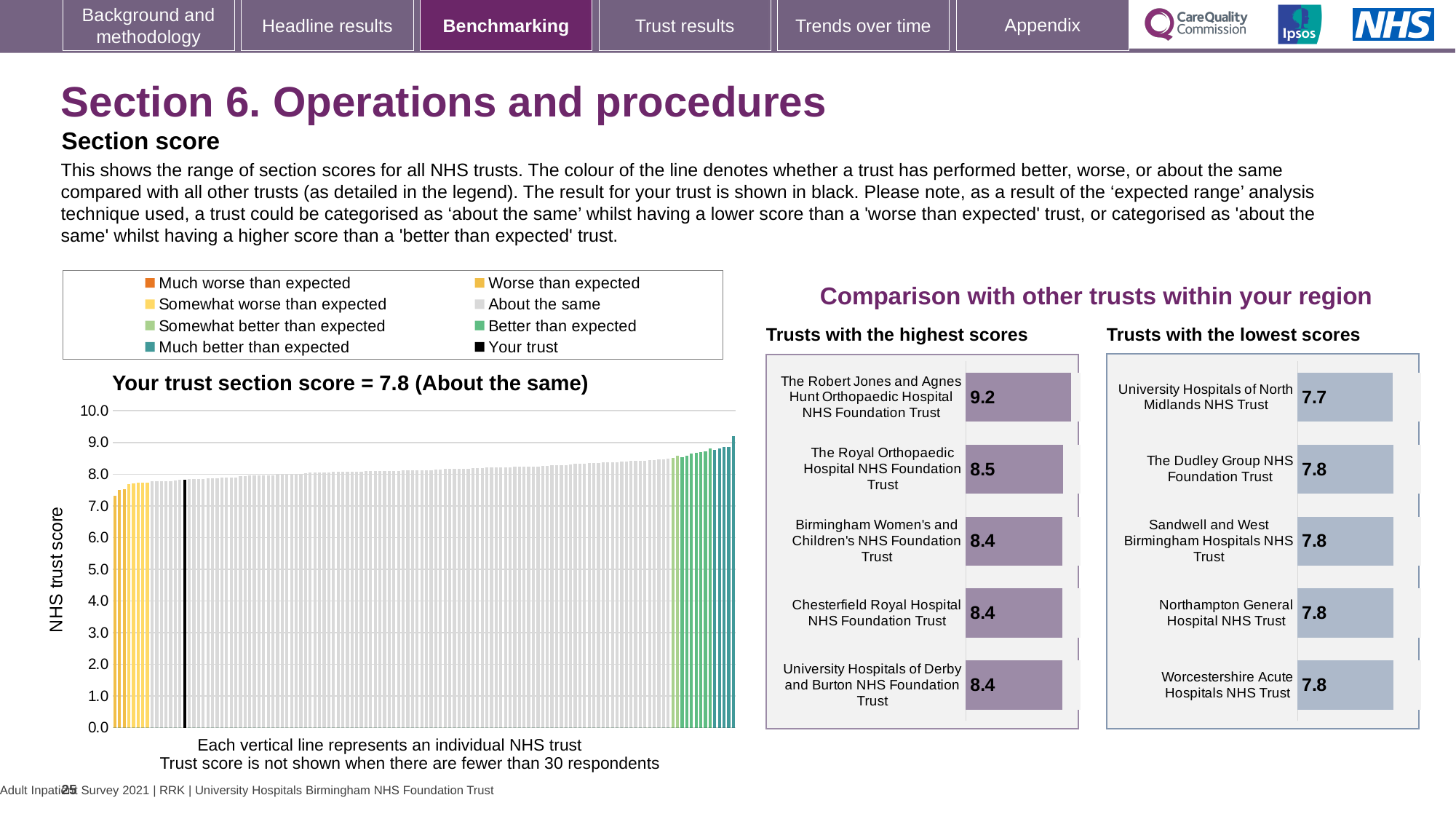
In the chart 'Your trust section score = 7.8 (About the same)', is the value of the tallest bar greater or less than 9.0? greater How many entries does the legend above the chart 'Your trust section score = 7.8 (About the same)' list? 8 What is the y-axis label of the chart 'Your trust section score = 7.8 (About the same)'? NHS trust score What kind of chart is 'Your trust section score = 7.8 (About the same)'? bar chart How many trusts are shown in the chart 'Trusts with the lowest scores'? 5 In the chart 'Your trust section score = 7.8 (About the same)', do the bars rise or fall from left to right? rise In the chart 'Your trust section score = 7.8 (About the same)', what is the section score for your trust? 7.8 In the chart 'Trusts with the highest scores', which trust has the highest score? The Robert Jones and Agnes Hunt Orthopaedic Hospital NHS Foundation Trust In the chart 'Trusts with the lowest scores', which trust has the lowest score? University Hospitals of North Midlands NHS Trust In the chart 'Trusts with the highest scores', what is the difference between the scores of The Robert Jones and Agnes Hunt Orthopaedic Hospital NHS Foundation Trust and The Royal Orthopaedic Hospital NHS Foundation Trust? 0.7 In the chart 'Trusts with the highest scores', what is the score for The Royal Orthopaedic Hospital NHS Foundation Trust? 8.5 In the chart 'Your trust section score = 7.8 (About the same)', is the value of the shortest bar greater or less than 7.0? greater